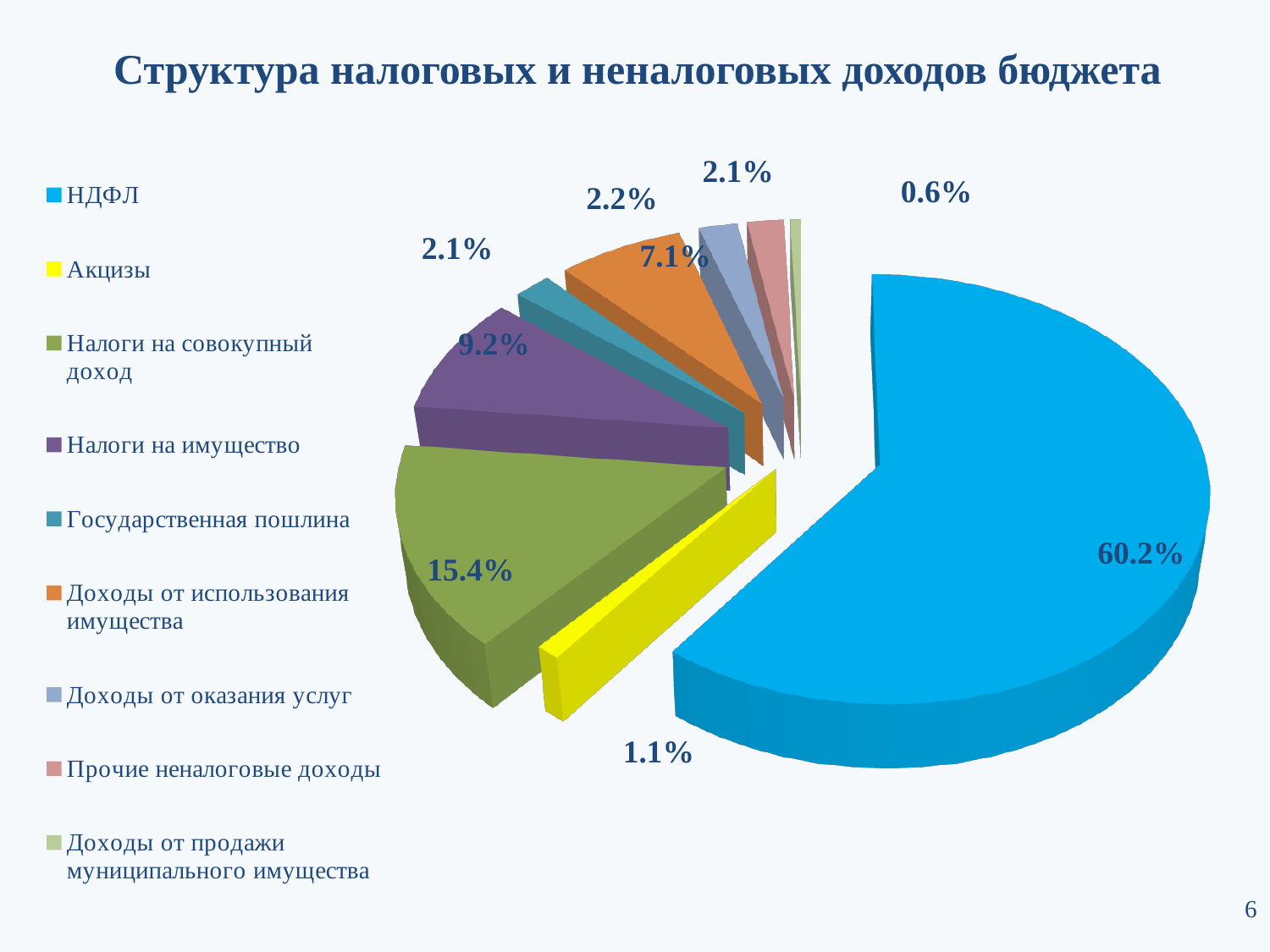
What is the share for Доходы от использования имущества? 7.1% Which category has the largest share of the pie? НДФЛ What is the title of the chart? Структура налоговых и неналоговых доходов бюджета What kind of chart is shown on the slide? pie chart What is the share for НДФЛ? 60.2% How many categories does the legend list? 9 What is the share for Налоги на имущество? 9.2% What is the difference between the shares of НДФЛ and Налоги на совокупный доход? 44.8% Which category has the smallest share of the pie? Доходы от продажи муниципального имущества What is the share for Налоги на совокупный доход? 15.4% Which is larger, the share for Налоги на имущество or the share for Доходы от использования имущества? Налоги на имущество What is the share for Акцизы? 1.1%